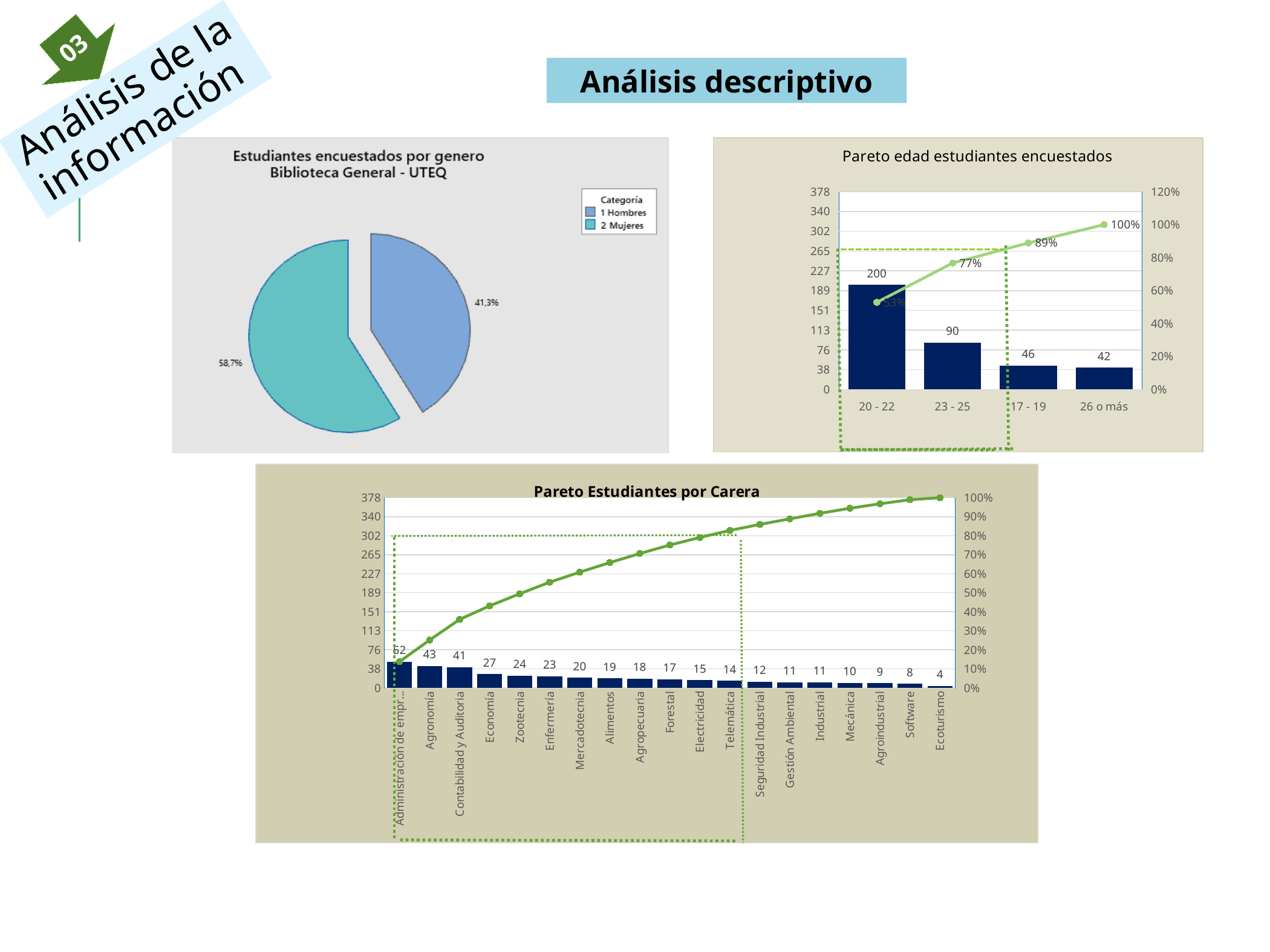
In the chart 'Pareto edad estudiantes encuestados', which age group has the lowest value? 26 o más In the pie chart 'Estudiantes encuestados por genero', what share is shown for 2 Mujeres? 58,7% In the chart 'Pareto edad estudiantes encuestados', what is the difference between the 20 - 22 and 23 - 25 values? 110 In the chart 'Pareto Estudiantes por Carera', which career has the lowest value? Ecoturismo In the chart 'Pareto Estudiantes por Carera', how many careers are shown on the x axis? 19 In the chart 'Pareto edad estudiantes encuestados', what is the value for the 20 - 22 age group? 200 In the chart 'Pareto edad estudiantes encuestados', what cumulative percentage is labelled at the 23 - 25 point on the line? 77% In the pie chart 'Estudiantes encuestados por genero', which category has the larger slice? 2 Mujeres In the chart 'Pareto Estudiantes por Carera', do the bar values rise or fall from left to right? fall In the chart 'Pareto Estudiantes por Carera', what is the value for Agronomía? 43 In the pie chart 'Estudiantes encuestados por genero', what share is shown for 1 Hombres? 41,3% In the chart 'Pareto edad estudiantes encuestados', what is the value for the 23 - 25 age group? 90